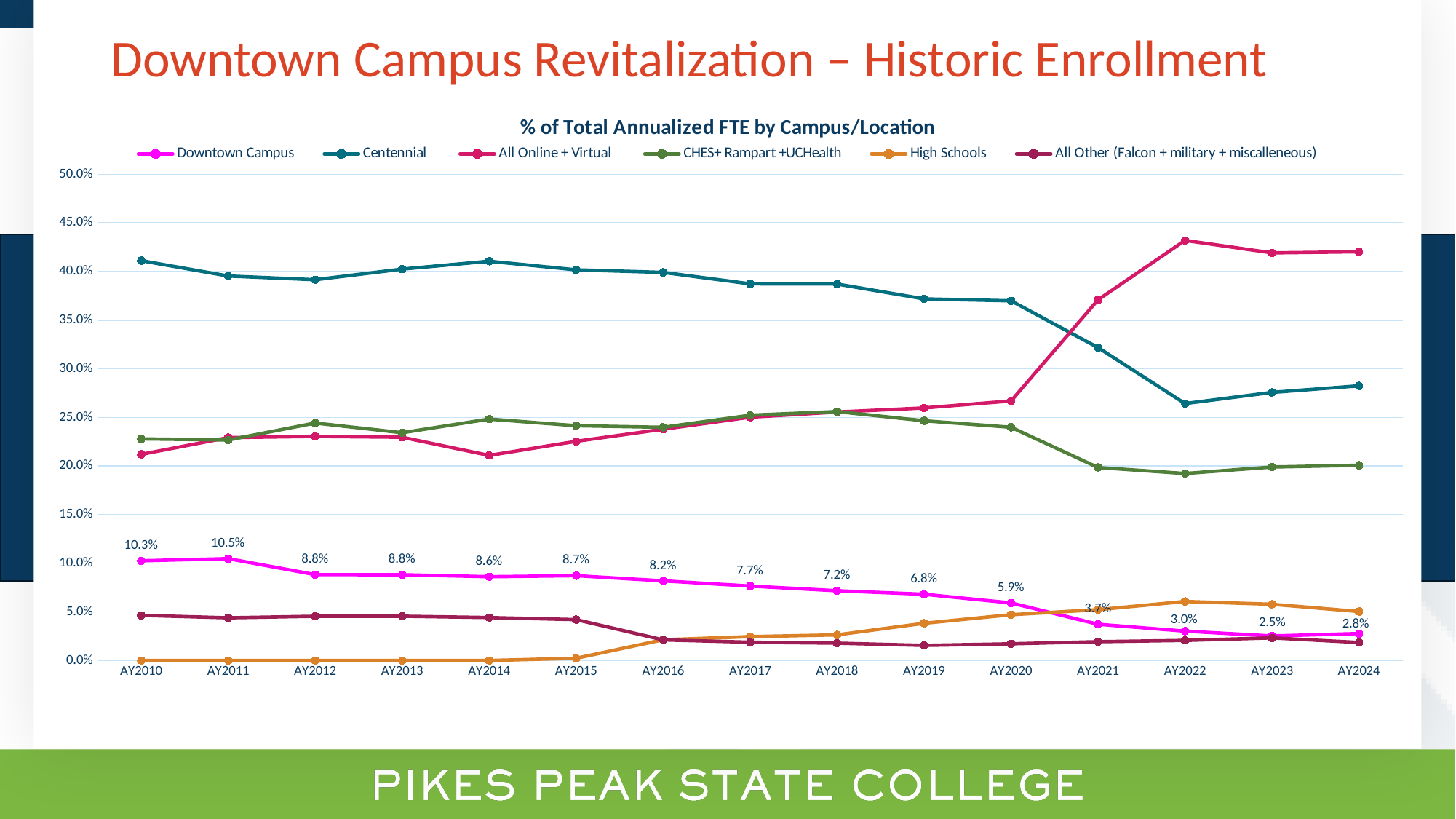
Is the Centennial value for AY2010 greater or less than 40.0%? greater What is the Downtown Campus value for AY2020? 5.9% What is the Downtown Campus value for AY2011? 10.5% What is the Downtown Campus value for AY2024? 2.8% How many series does the legend list? 6 What is the title of the chart? % of Total Annualized FTE by Campus/Location What kind of chart is shown on the slide? line chart How many academic years are plotted along the x axis? 15 In which academic year is the Downtown Campus value highest? AY2011 What is the difference between the Downtown Campus values for AY2010 and AY2024? 7.5% Does the Downtown Campus series generally rise or fall from AY2010 to AY2024? fall In which academic year is the Downtown Campus value lowest? AY2023